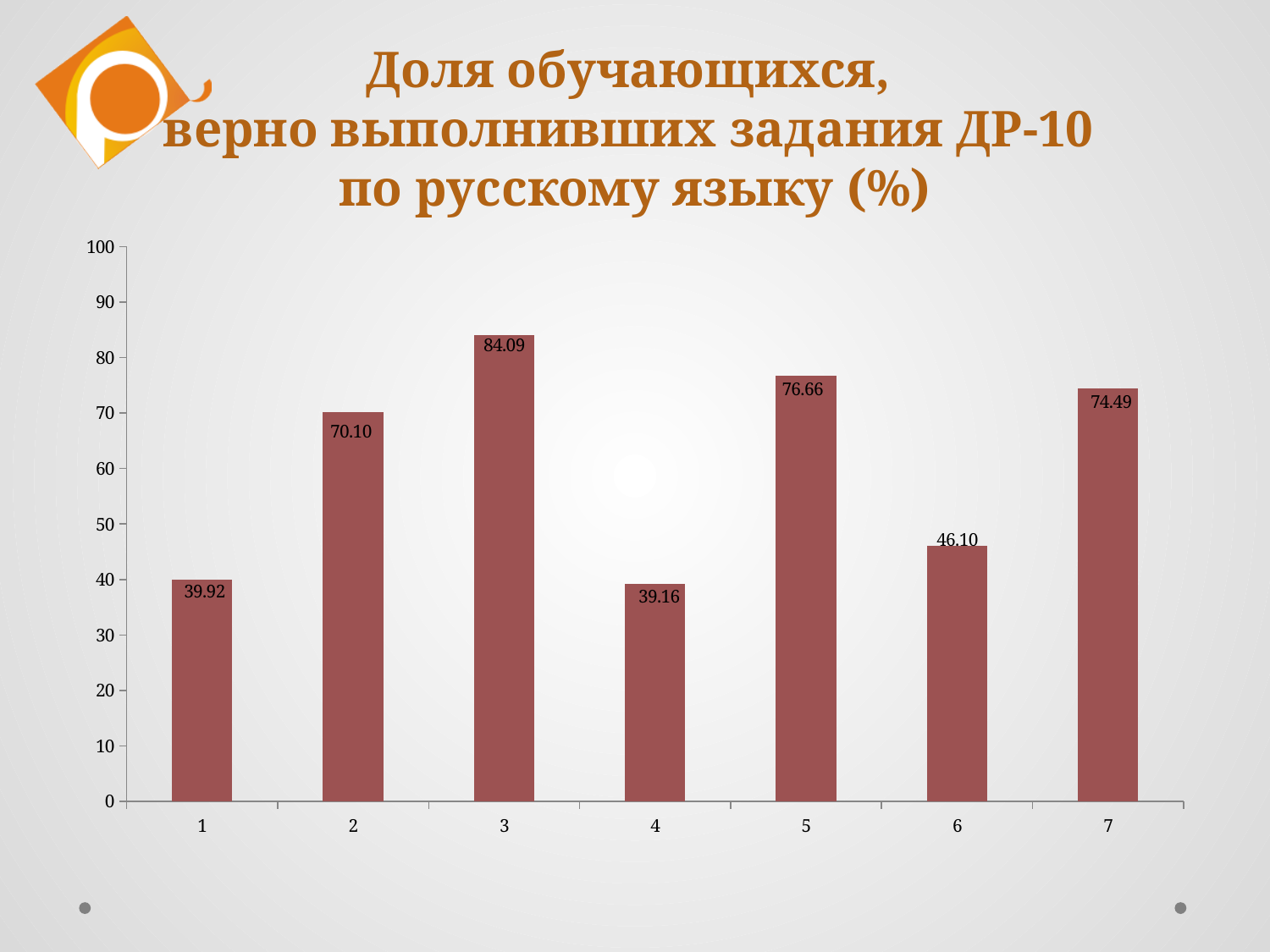
Is the value for category 2 greater or less than 60? greater Which is larger, the value for category 5 or the value for category 7? 5 What is the value for category 6? 46.10 What is the value for category 1? 39.92 What kind of chart is shown on the slide? bar chart What is the value for category 3? 84.09 What is the difference between the values for category 5 and category 2? 6.56 Which category has the highest value? 3 What is the difference between the values for category 3 and category 4? 44.93 What is the maximum value shown on the y axis? 100 How many categories are shown on the x axis? 7 Which category has the lowest value? 4